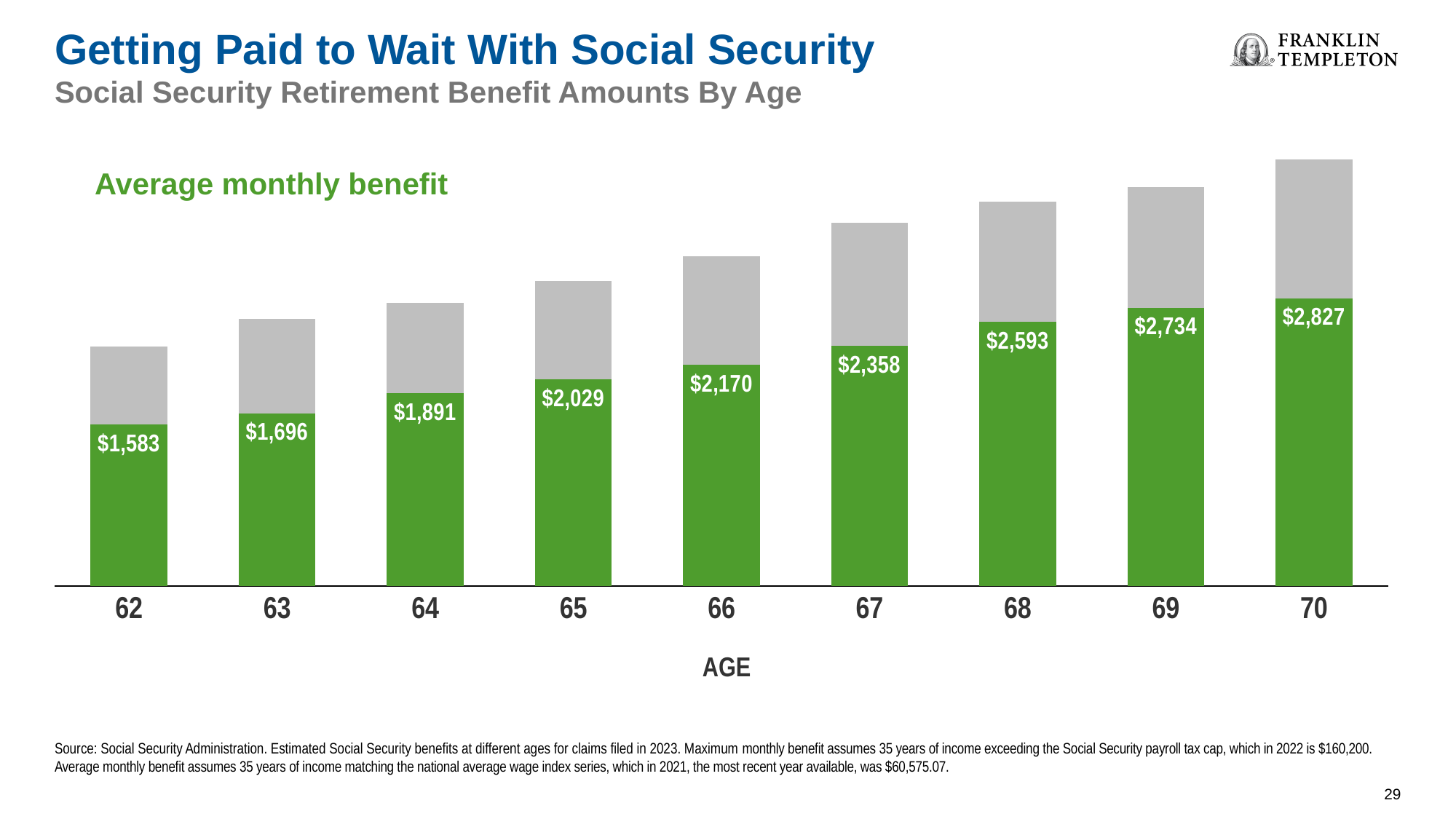
Does the average monthly benefit rise or fall as age increases from 62 to 70? rise How many ages are shown on the x axis of the chart? 9 Which is larger, the average monthly benefit at age 65 or at age 64? age 65 What is the difference between the average monthly benefit at age 70 and at age 62? $1,244 What kind of chart is shown on the slide? bar chart What is the average monthly benefit at age 62? $1,583 At which age is the average monthly benefit lowest? 62 What is the average monthly benefit at age 68? $2,593 At which age is the average monthly benefit highest? 70 What is the difference between the average monthly benefit at age 67 and at age 66? $188 What is the average monthly benefit at age 66? $2,170 What is the average monthly benefit at age 70? $2,827